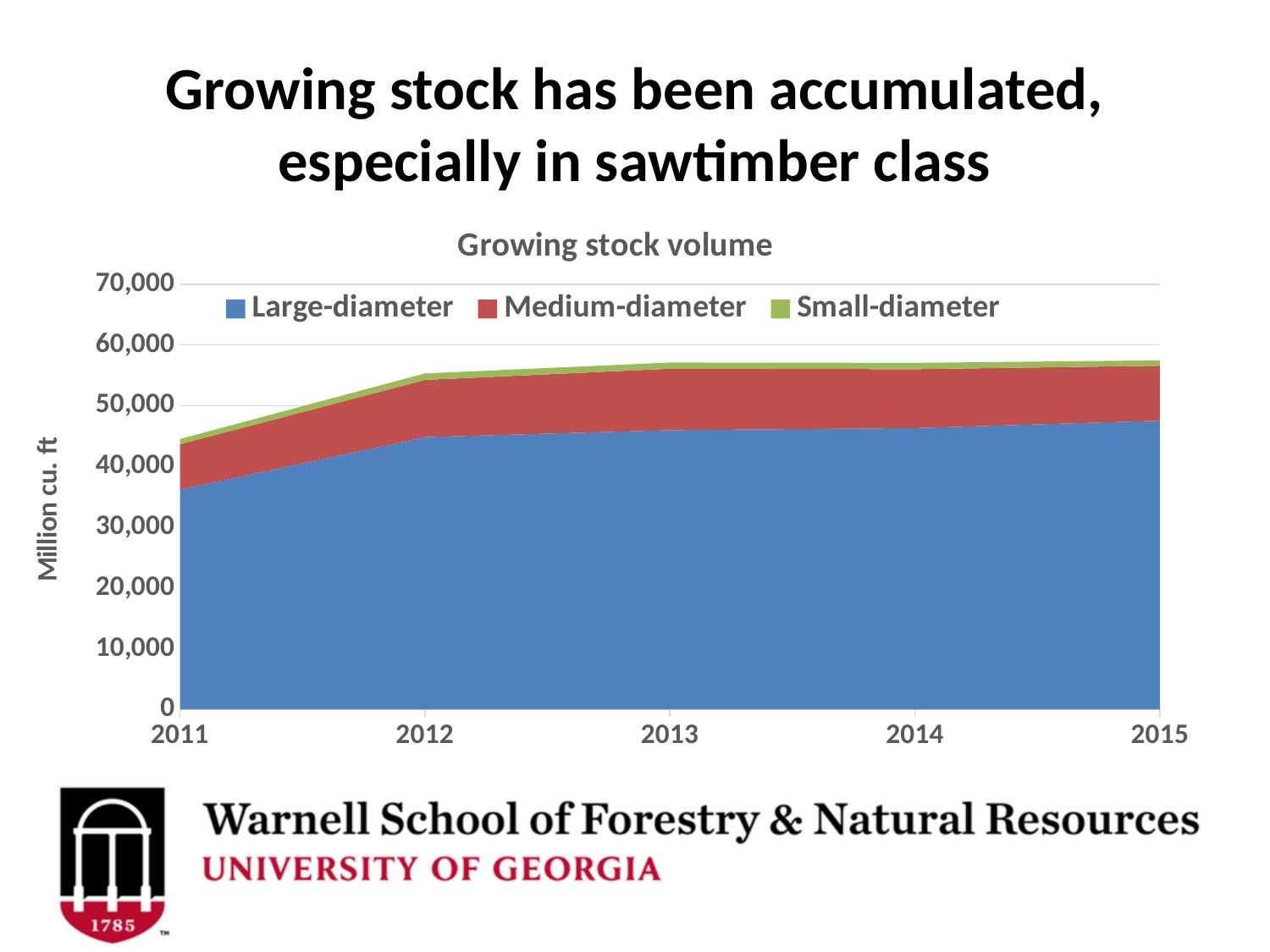
What is the title of the chart? Growing stock volume Is the Large-diameter value for 2015 greater or less than 40,000? greater Does the total growing stock volume rise or fall from 2011 to 2015? Rise In which year is the total growing stock volume lowest? 2011 What is the label on the vertical axis? Million cu. ft Is the total growing stock volume in 2013 greater or less than 50,000? greater How many series does the legend list? 3 What kind of chart is shown on the slide? Stacked area chart How many years are shown on the x axis? 5 Is the Large-diameter value for 2011 greater or less than 40,000? less In which year is the Large-diameter volume lowest? 2011 Which is larger, the Large-diameter volume in 2011 or in 2013? 2013